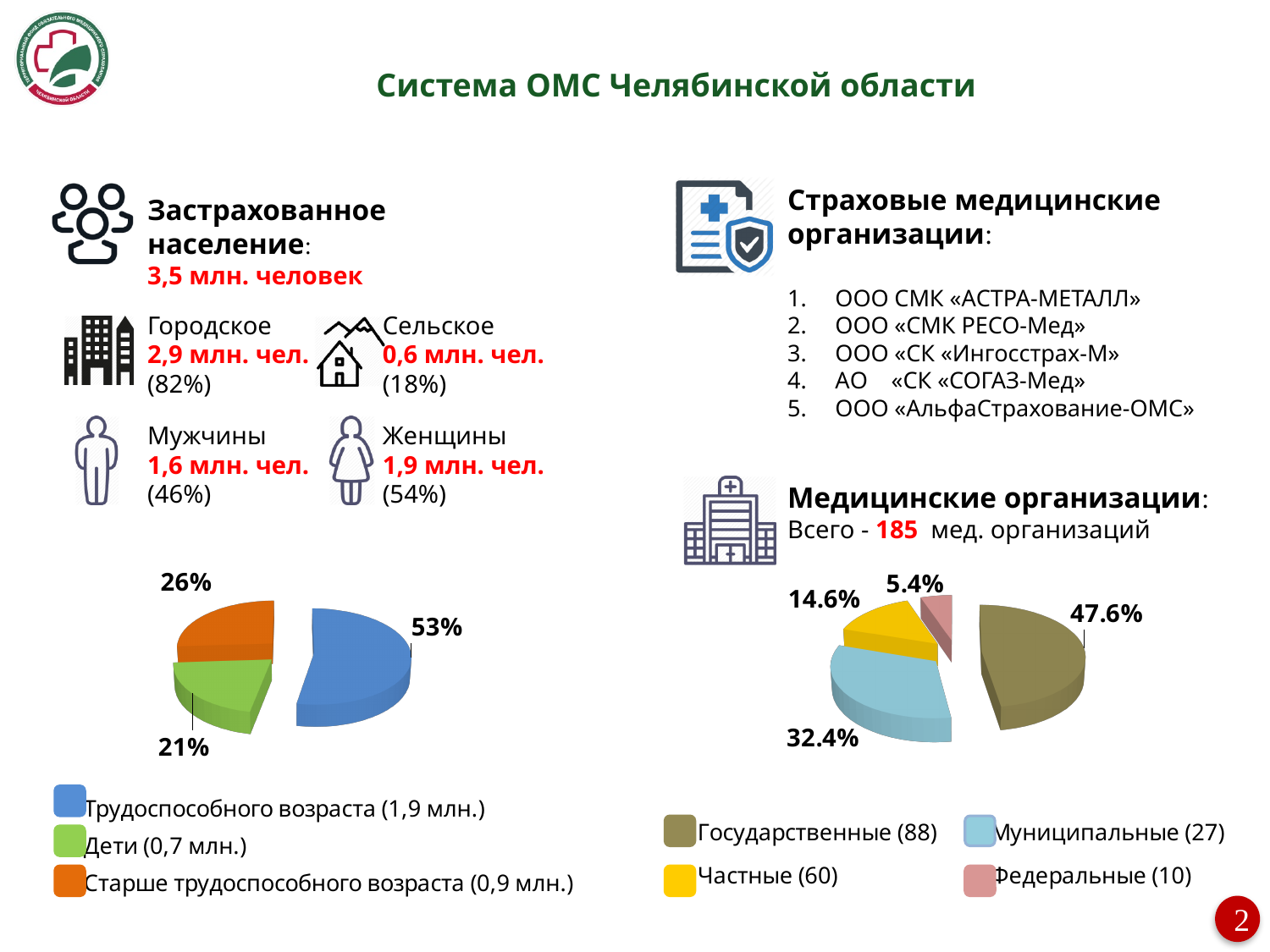
On the left pie chart, which category has the smallest slice? Дети What type of chart is used for Медицинские организации on the right? Pie chart On the left pie chart, what share is shown for Старше трудоспособного возраста? 26% On the left pie chart, how many slices are there? 3 On the right pie chart (Медицинские организации), what share is shown for Федеральные? 5.4% On the left pie chart, what share is shown for Трудоспособного возраста? 53% On the left pie chart, what share is shown for Дети? 21% On the left pie chart, which category has the largest slice? Трудоспособного возраста On the right pie chart (Медицинские организации), which category has the smallest slice? Федеральные On the left pie chart, what is the difference in percentage points between Старше трудоспособного возраста and Дети? 5 On the right pie chart (Медицинские организации), which category has the largest slice? Государственные On the right pie chart (Медицинские организации), what share is shown for Государственные? 47.6%